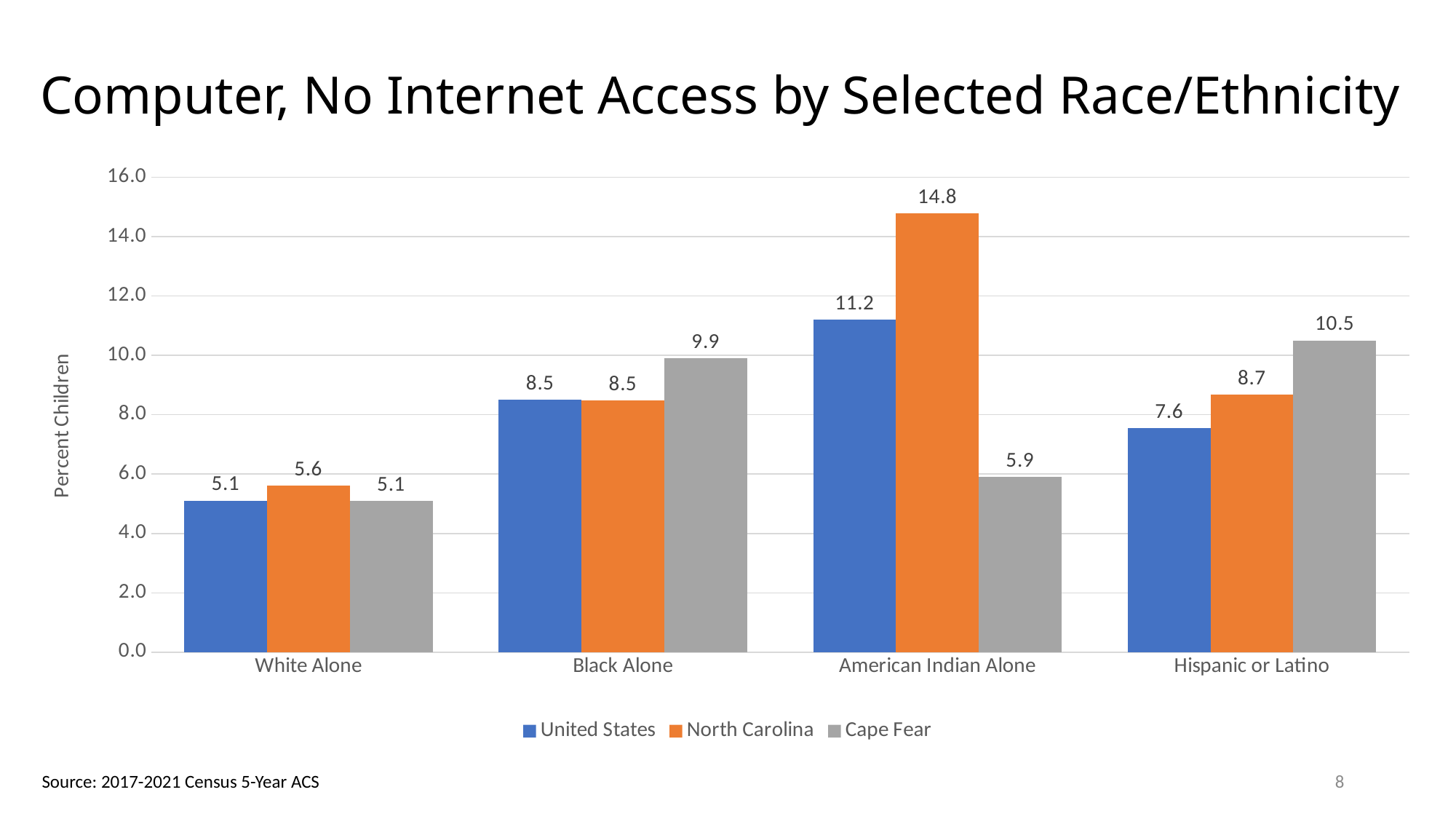
Which race/ethnicity category has the lowest North Carolina value? White Alone How many race/ethnicity categories are shown on the x axis? 4 What kind of chart is shown on the slide? Bar chart What is the North Carolina value for American Indian Alone? 14.8 What is the label on the vertical axis? Percent Children Which is larger for Black Alone: the Cape Fear value or the United States value? Cape Fear What is the difference between the North Carolina and Cape Fear values for American Indian Alone? 8.9 What is the Cape Fear value for Hispanic or Latino? 10.5 What is the United States value for White Alone? 5.1 Is the United States value for American Indian Alone greater or less than 10.0? greater How many series does the legend list? 3 Which race/ethnicity category has the highest Cape Fear value? Hispanic or Latino